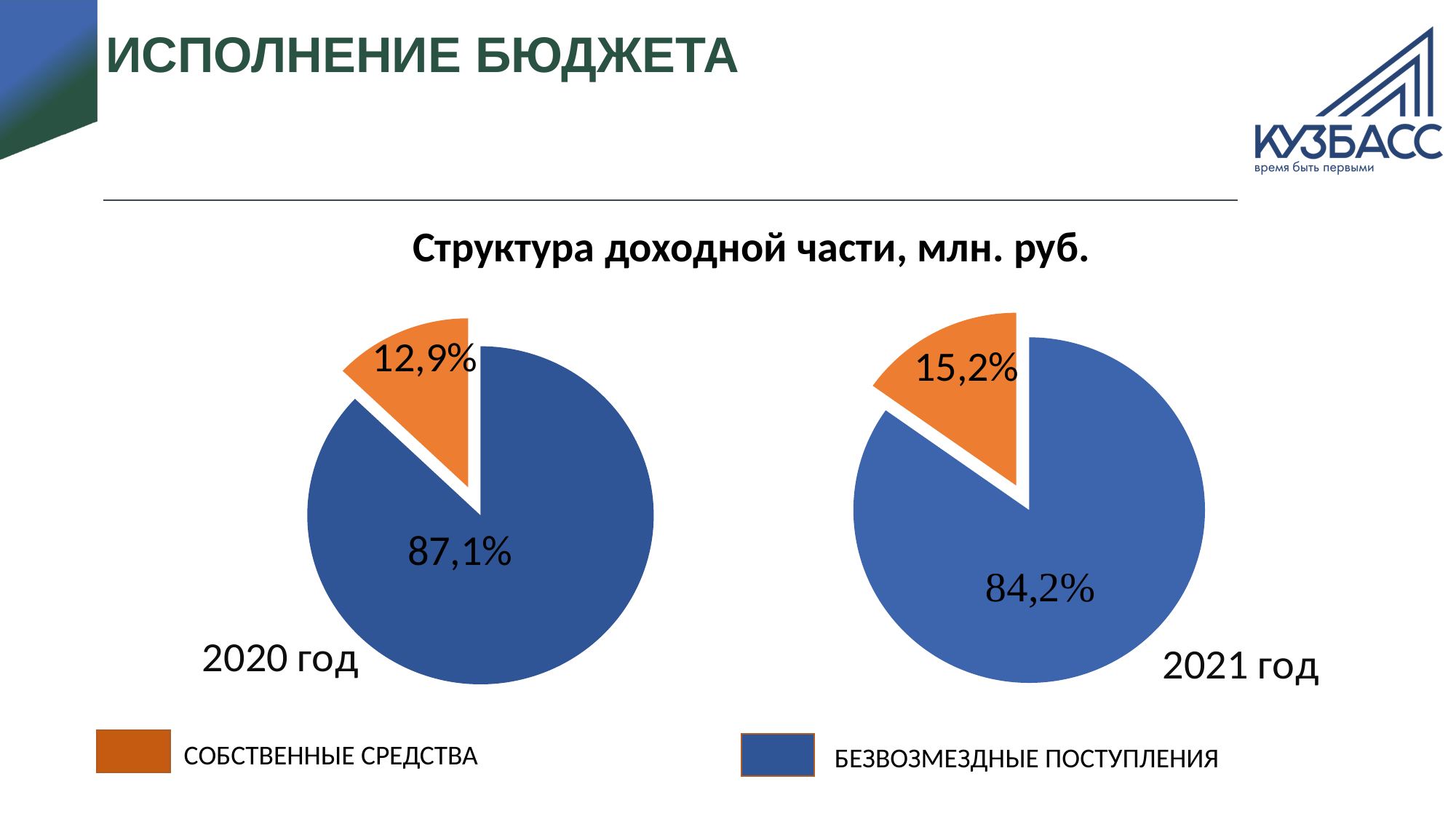
What is the title shown above the two pie charts? Структура доходной части, млн. руб. In the 2021 год pie chart, what share is labelled for БЕЗВОЗМЕЗДНЫЕ ПОСТУПЛЕНИЯ (blue slice)? 84,2% In the 2021 год pie chart, what share is labelled for СОБСТВЕННЫЕ СРЕДСТВА (orange slice)? 15,2% In the 2021 год pie chart, which category has the largest slice? БЕЗВОЗМЕЗДНЫЕ ПОСТУПЛЕНИЯ By how many percentage points did the share of СОБСТВЕННЫЕ СРЕДСТВА change from the 2020 год pie chart to the 2021 год pie chart? 2,3 In the 2020 год pie chart, what is the difference in percentage points between the БЕЗВОЗМЕЗДНЫЕ ПОСТУПЛЕНИЯ slice and the СОБСТВЕННЫЕ СРЕДСТВА slice? 74,2 How many slices does the 2021 год pie chart have? 2 Is the share of СОБСТВЕННЫЕ СРЕДСТВА larger in the 2020 год pie chart or the 2021 год pie chart? 2021 год In the 2020 год pie chart, which category has the smallest slice? СОБСТВЕННЫЕ СРЕДСТВА What type of chart is used for the 2020 год data? pie chart In the 2020 год pie chart, what share is labelled for СОБСТВЕННЫЕ СРЕДСТВА (orange slice)? 12,9% In the 2020 год pie chart, what share is labelled for БЕЗВОЗМЕЗДНЫЕ ПОСТУПЛЕНИЯ (blue slice)? 87,1%